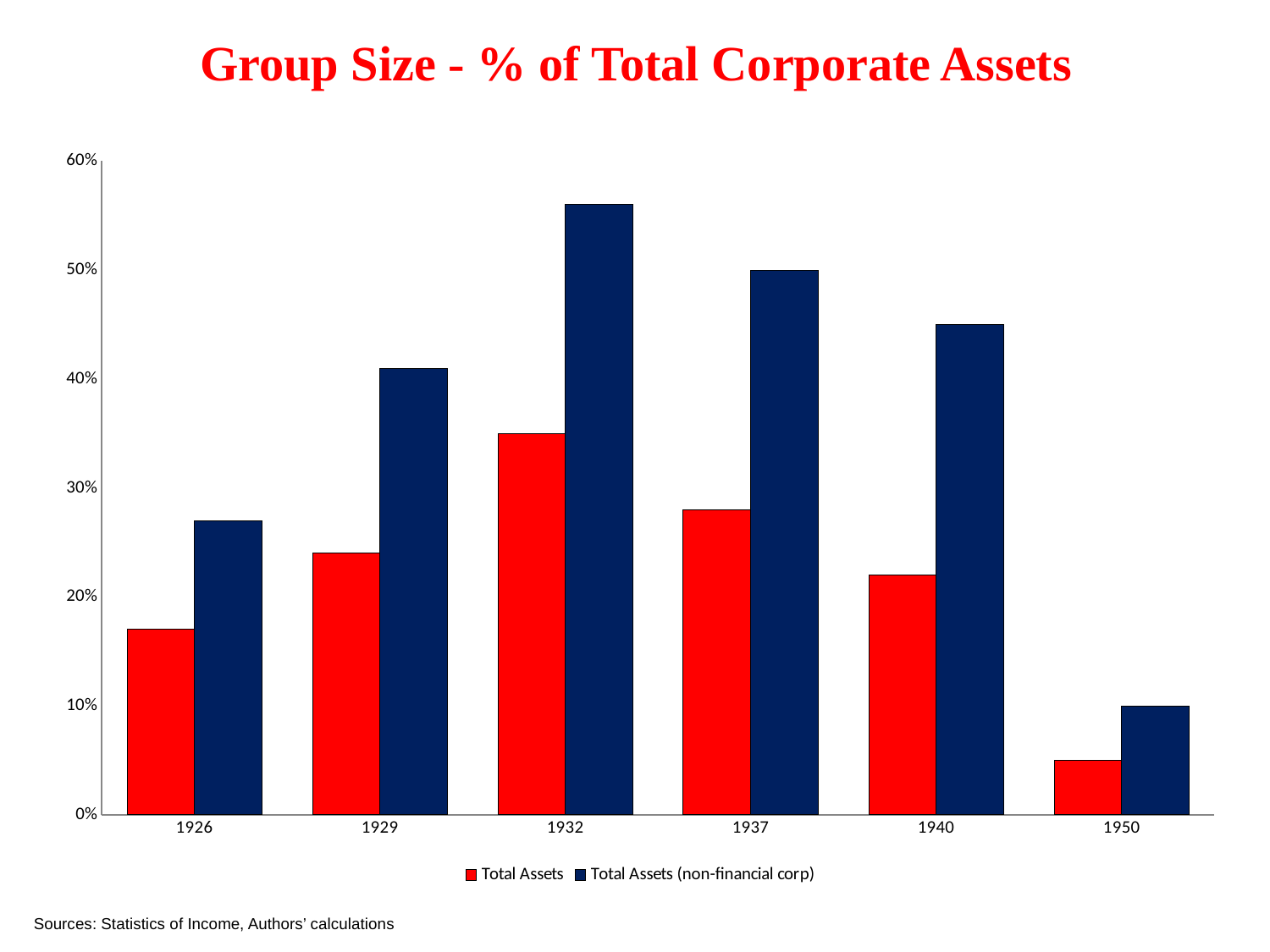
What kind of chart is shown on the slide? bar chart Is the value for Total Assets (non-financial corp) in 1929 greater or less than 40%? greater How many series does the legend list? 2 Is the value for Total Assets in 1926 greater or less than 20%? less Do the Total Assets values rise or fall from 1932 to 1950? fall Is the value for Total Assets (non-financial corp) in 1932 greater or less than 50%? greater Which year has the highest value for Total Assets? 1932 Which is larger in 1940: Total Assets or Total Assets (non-financial corp)? Total Assets (non-financial corp) Which year has the highest value for Total Assets (non-financial corp)? 1932 What is the title of the chart? Group Size - % of Total Corporate Assets Which year has the lowest value for Total Assets? 1950 How many years are shown on the x axis? 6